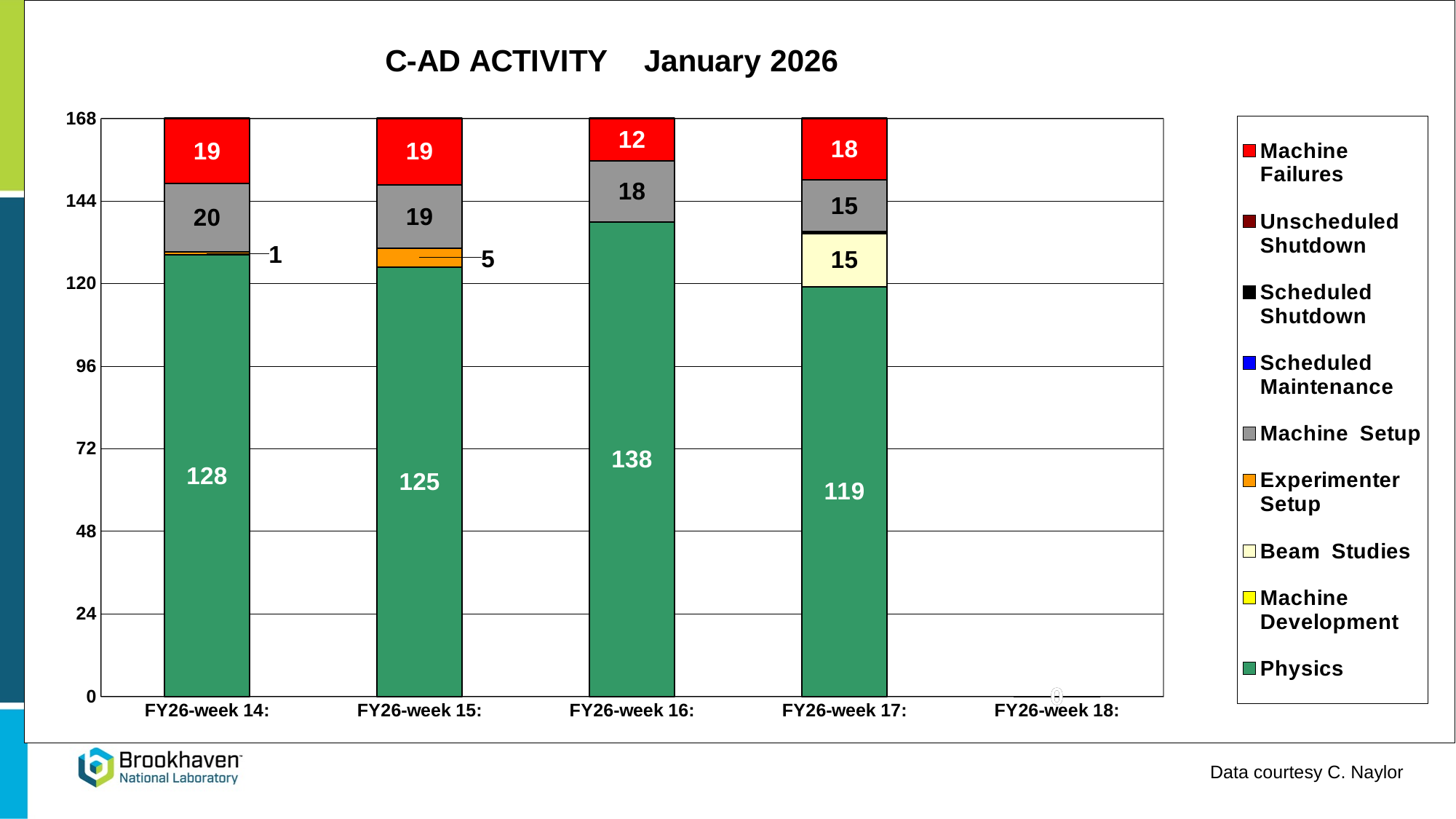
What is the total of the stacked bar for FY26-week 16? 168 What is the Beam Studies value for FY26-week 17? 15 What is the Physics value for FY26-week 16? 138 Which week has the lowest Machine Failures value? FY26-week 16 Which is larger, the Machine Setup value for FY26-week 14 or for FY26-week 16? FY26-week 14 What is the Experimenter Setup value for FY26-week 15? 5 Which week has the highest Physics value? FY26-week 16 What kind of chart is shown on the slide? stacked bar chart What is the Machine Failures value for FY26-week 17? 18 What is the difference between the Physics values for FY26-week 16 and FY26-week 17? 19 Which week has the lowest Physics value? FY26-week 17 How many series does the legend list? 9